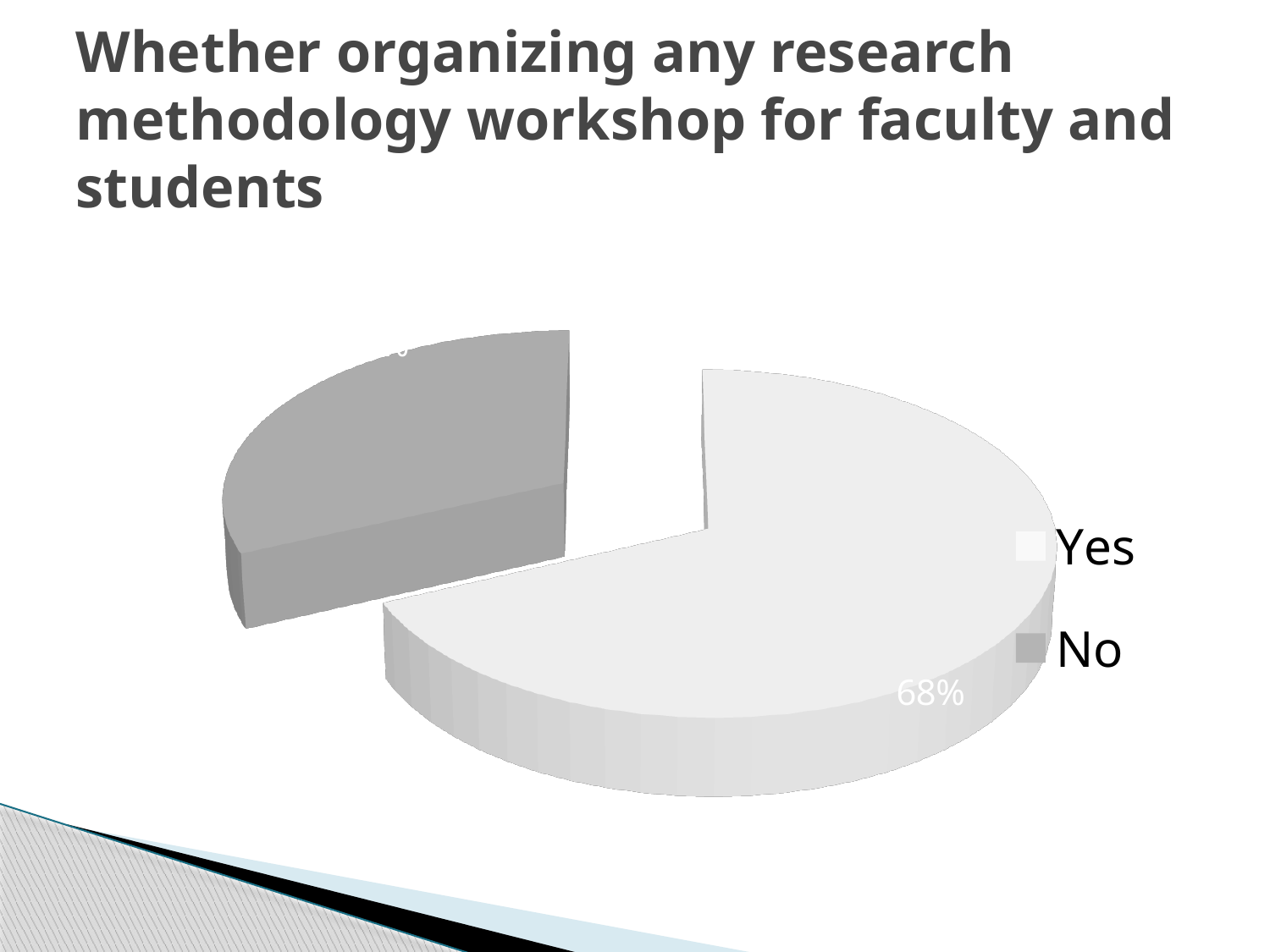
What percentage of the pie is labelled for the Yes slice? 68% What share of the pie does the Yes slice represent? 68% Which legend entry is shown in the darker grey colour? No Which slice is larger, Yes or No? Yes What are the two legend entries of the pie chart? Yes and No How many entries does the legend list? 2 Which category has the smallest share of the pie? No Which category has the largest share of the pie? Yes How many categories does the pie chart have? 2 What kind of chart is shown on the slide? pie chart